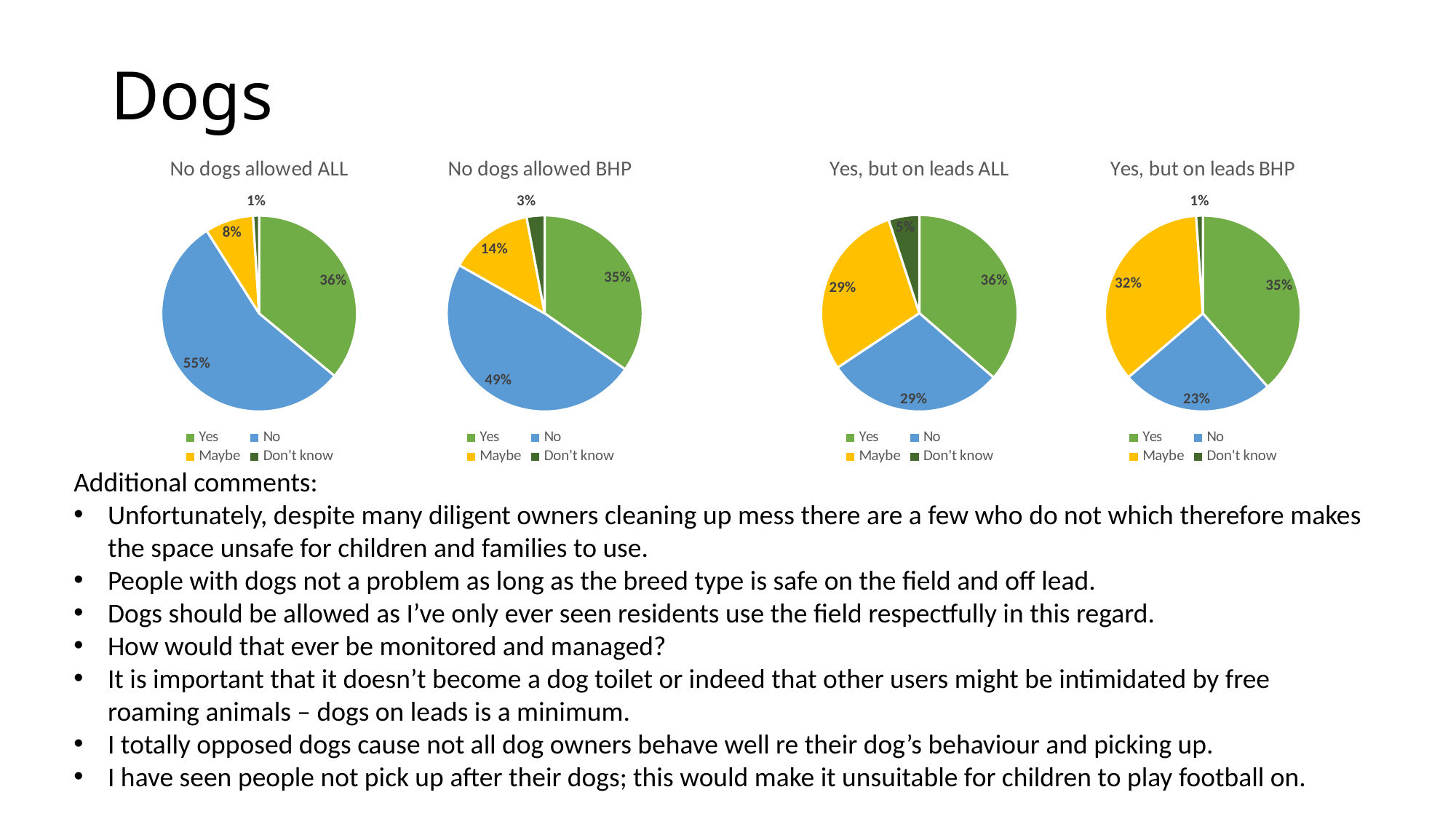
In the "No dogs allowed ALL" chart, what share of responses is "No"? 55% How many pie charts are shown on the slide? 4 In the "Yes, but on leads BHP" chart, which is larger, the "Maybe" slice or the "No" slice? Maybe In the "Yes, but on leads ALL" chart, what share of responses is "Don't know"? 5% In the "Yes, but on leads BHP" chart, what share of responses is "Maybe"? 32% In the "No dogs allowed BHP" chart, what is the difference between the "No" and "Yes" shares? 14% In the "No dogs allowed ALL" chart, which response has the largest slice? No In the "No dogs allowed ALL" chart, what colour represents "Maybe"? Yellow How many categories does the legend of the "No dogs allowed ALL" chart list? 4 What type of chart is used for "Yes, but on leads ALL"? Pie chart In the "No dogs allowed BHP" chart, what share of responses is "Maybe"? 14% In the "Yes, but on leads BHP" chart, which response has the smallest slice? Don't know